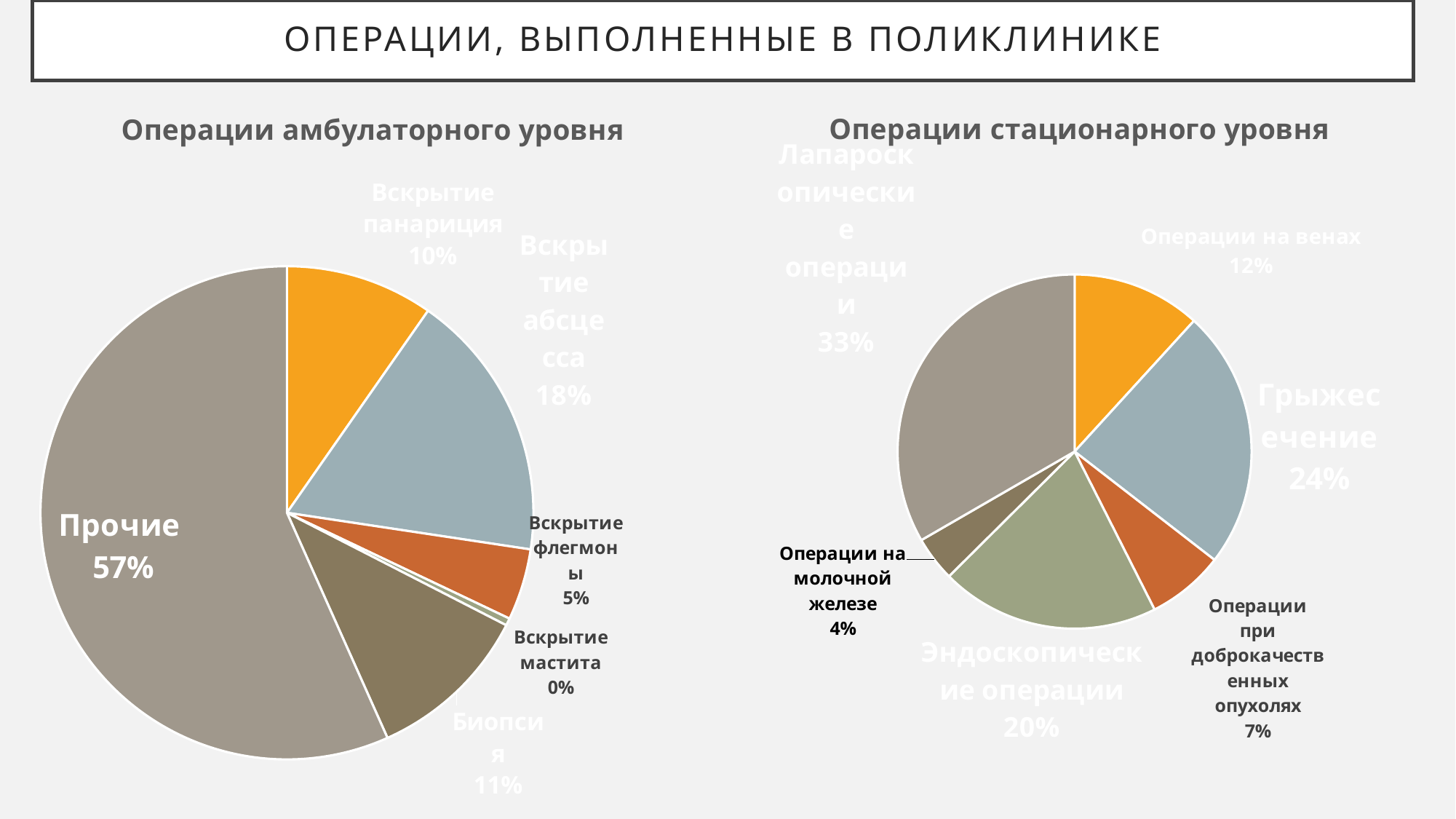
In the "Операции амбулаторного уровня" chart, what share does "Прочие" have? 57% In the "Операции амбулаторного уровня" chart, what is the value for "Вскрытие абсцесса"? 18% In the "Операции амбулаторного уровня" chart, what is the difference between "Вскрытие абсцесса" and "Вскрытие панариция"? 8% How many pie charts are shown on the slide? 2 In the "Операции стационарного уровня" chart, what is the difference between "Эндоскопические операции" and "Операции на венах"? 8% In the "Операции амбулаторного уровня" chart, which is larger: "Биопсия" or "Вскрытие флегмоны"? Биопсия In the "Операции стационарного уровня" chart, which category has the largest share? Лапароскопические операции In the "Операции амбулаторного уровня" chart, how many slices are there? 6 In the "Операции стационарного уровня" chart, what is the value for "Грыжесечение"? 24% In the "Операции амбулаторного уровня" chart, which category has the smallest share? Вскрытие мастита What type of chart is used for "Операции амбулаторного уровня"? pie chart In the "Операции стационарного уровня" chart, what share do "Операции на молочной железе" have? 4%